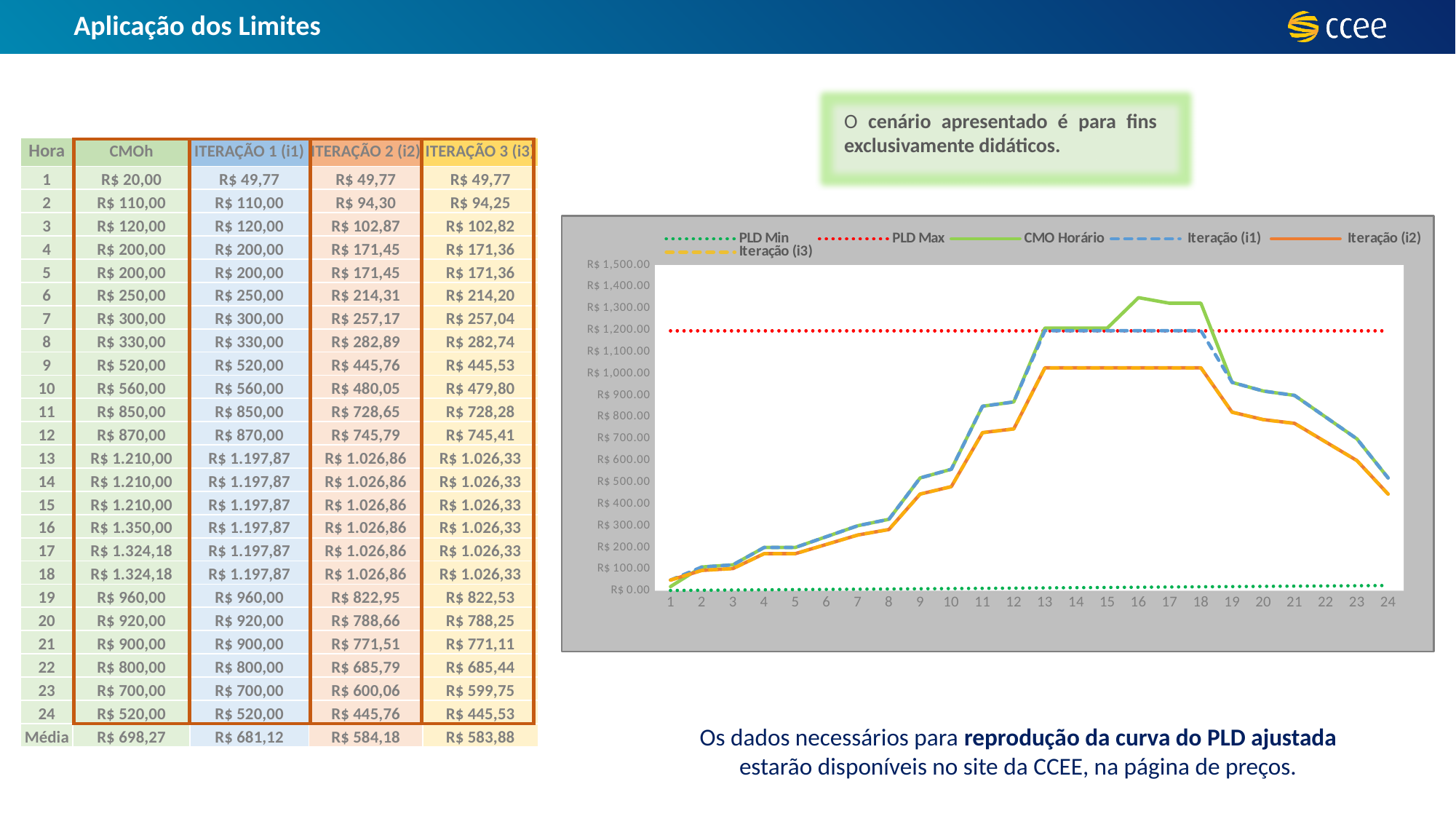
Is the value of CMO Horário at hour 16 greater or less than R$ 1,300.00? greater What kind of chart is shown on the slide? line chart Does the Iteração (i1) line rise or fall from hour 18 to hour 24? fall How many series does the chart legend list? 6 At hour 16, which is larger: CMO Horário or Iteração (i2)? CMO Horário Is the value of Iteração (i1) at hour 24 greater or less than R$ 400.00? greater What colour is the PLD Max line in the chart? red Is the value of Iteração (i2) at hour 13 greater or less than R$ 1,100.00? less At which hour does CMO Horário reach its highest value? 16 Does the CMO Horário line rise or fall from hour 1 to hour 13? rise How many hours are plotted along the x axis of the chart? 24